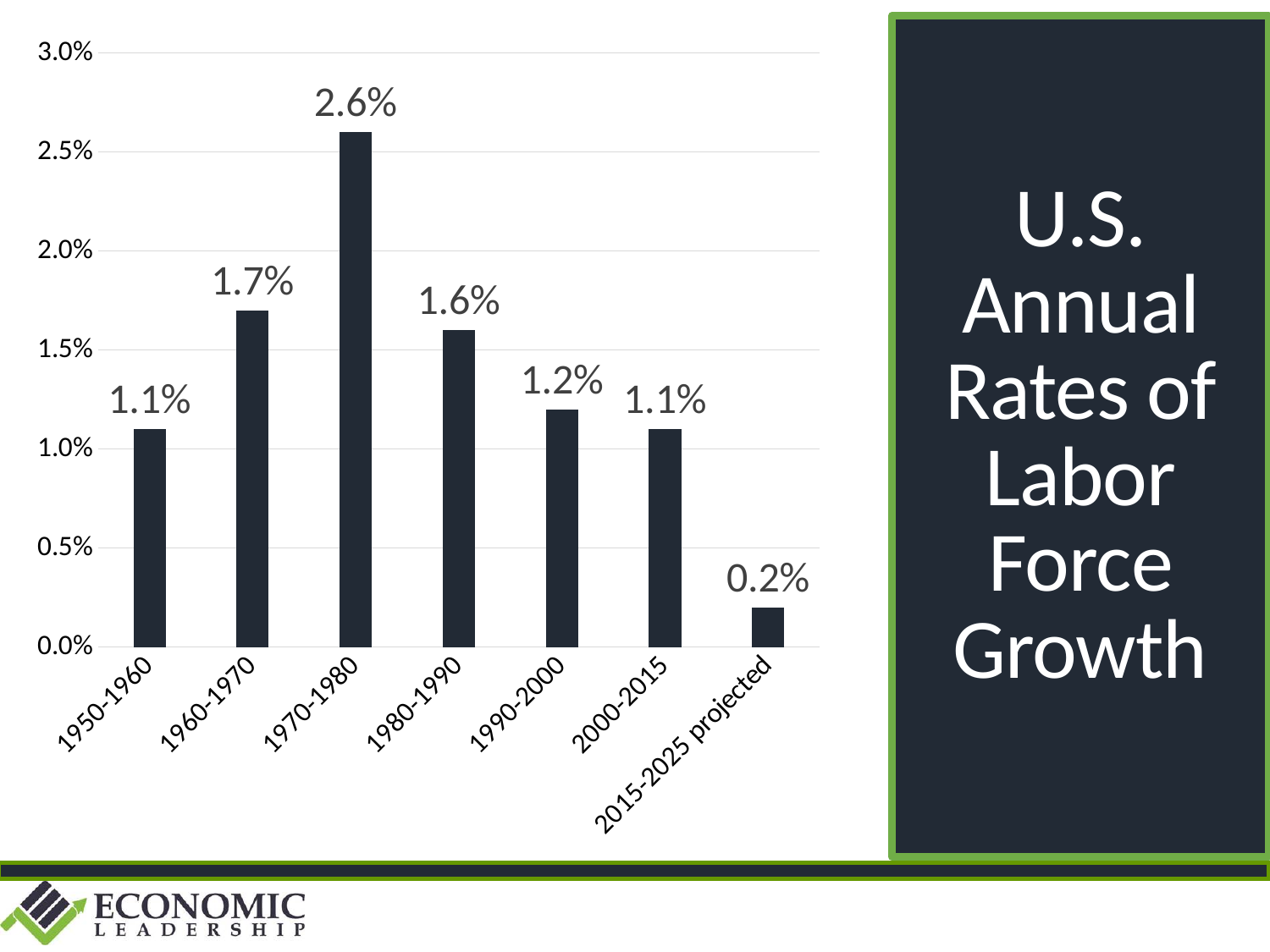
What is the difference between the growth rates for 1960-1970 and 2000-2015? 0.6% What kind of chart is shown on the slide? Bar chart Is the growth rate for 1970-1980 greater or less than 2.5%? greater What is the annual labor force growth rate for 1970-1980? 2.6% Which period has a higher growth rate, 1960-1970 or 1980-1990? 1960-1970 Which period has the lowest annual labor force growth rate? 2015-2025 projected What is the projected annual labor force growth rate for 2015-2025? 0.2% What is the difference between the growth rates for 1970-1980 and 1980-1990? 1.0% What is the annual labor force growth rate for 1990-2000? 1.2% Do the growth rates rise or fall from 1970-1980 onward? Fall How many time periods are shown on the chart? 7 Which period has the highest annual labor force growth rate? 1970-1980